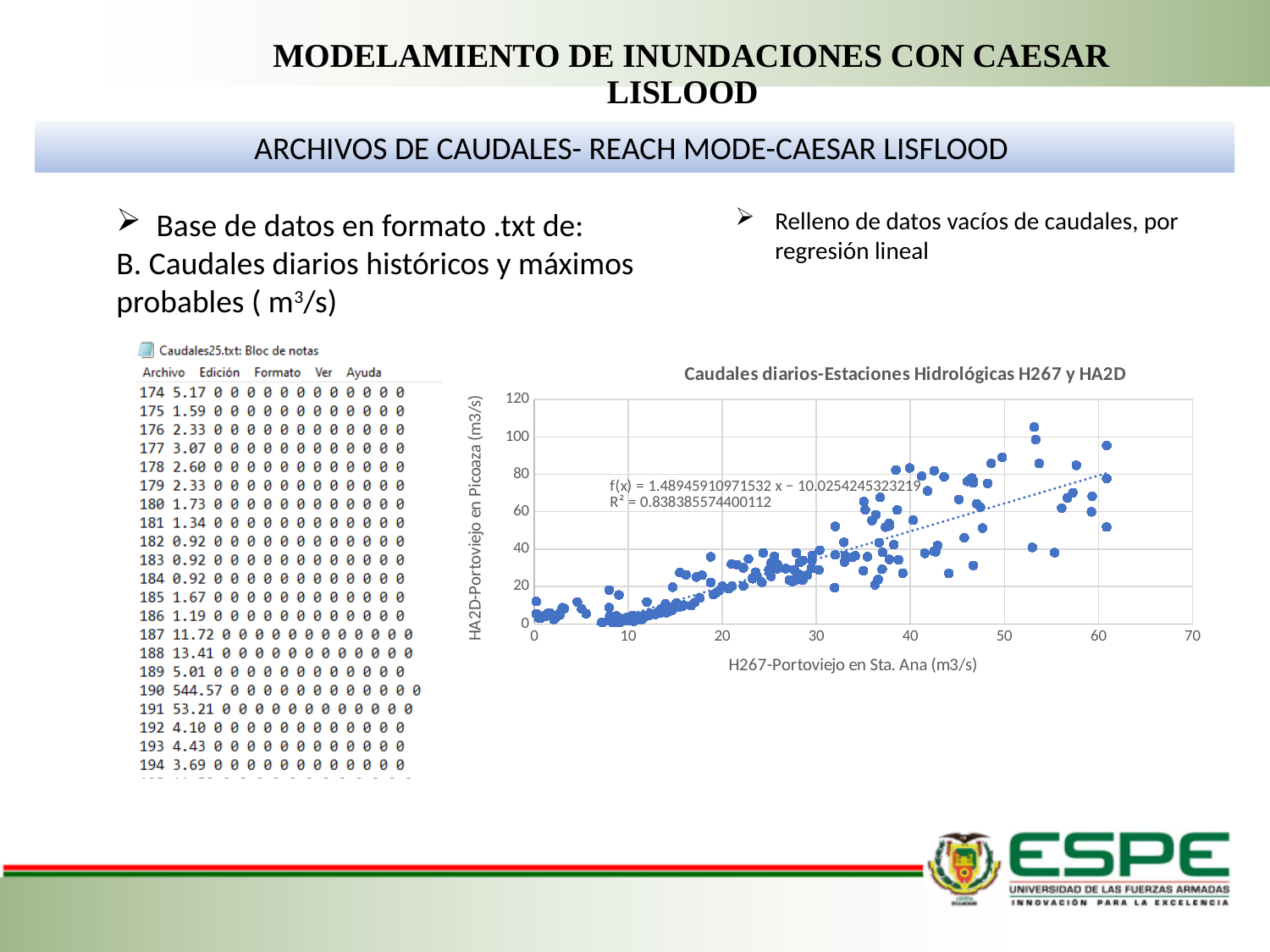
Is the highest plotted y value on the chart greater or less than 100? greater What is the R² value shown on the chart? 0.838385574400112 What is the maximum value shown on the x axis of the chart? 70 Do the plotted values generally rise or fall as the x-axis value increases? Rise What is the trendline equation shown on the chart? f(x) = 1.48945910971532 x − 10.0254245323219 What is the title of the chart on the slide? Caudales diarios-Estaciones Hidrológicas H267 y HA2D What is the slope of the linear trendline shown on the chart? 1.48945910971532 What is the maximum value shown on the y axis of the chart? 120 Is the largest x value among the plotted points greater or less than 70? less What is the label of the x axis of the chart? H267-Portoviejo en Sta. Ana (m3/s) What kind of chart is shown on the slide? Scatter chart